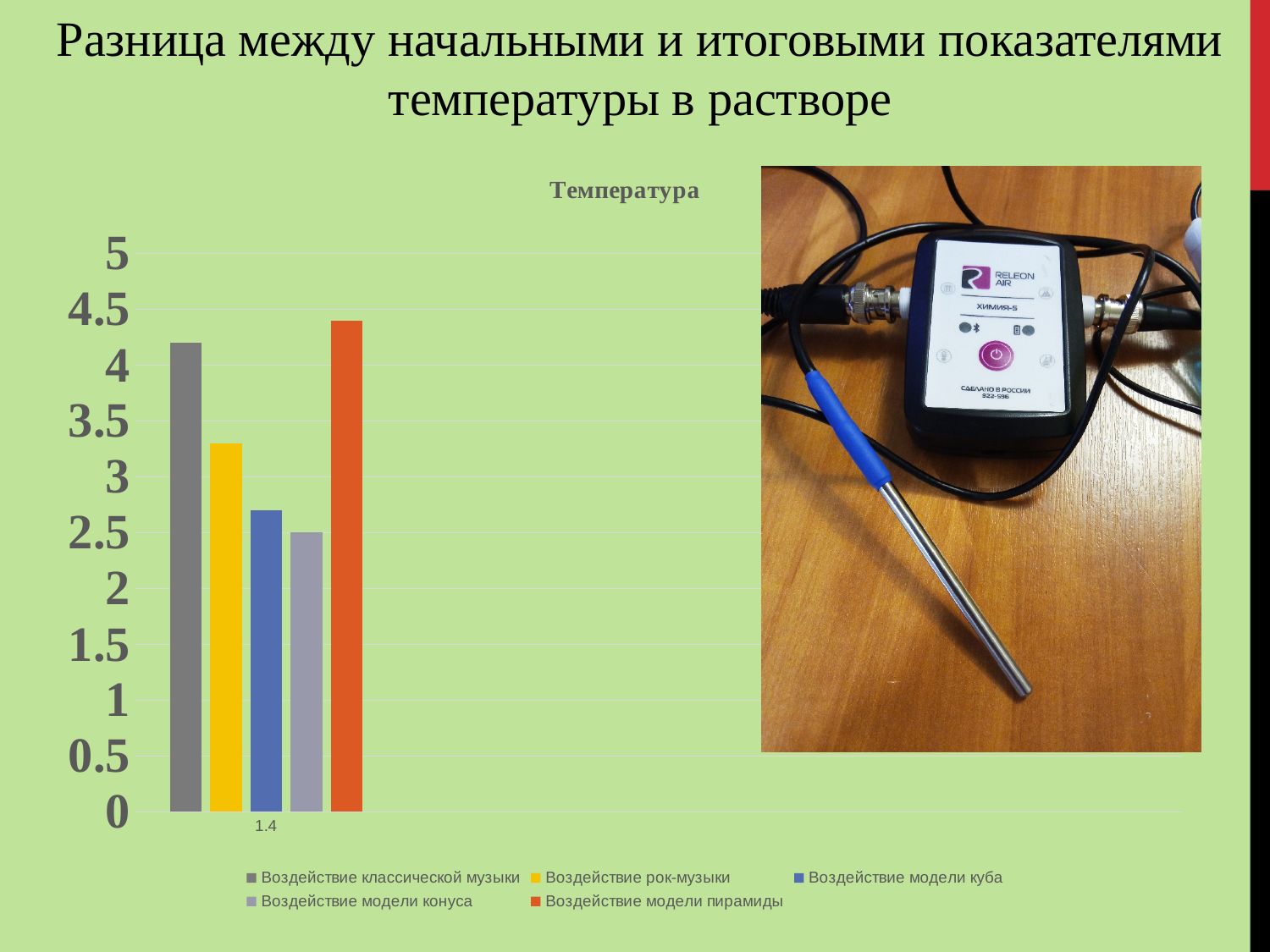
Is the value for Воздействие модели куба greater or less than 3? less Is the value for Воздействие классической музыки greater or less than 4? greater Is the value for Воздействие модели пирамиды greater or less than 4? greater Which is larger, the value for Воздействие модели куба or the value for Воздействие модели пирамиды? Воздействие модели пирамиды What colour is the bar for Воздействие рок-музыки? yellow What kind of chart is shown on the slide? bar chart Which series has the lowest bar in the chart? Воздействие модели конуса Which series has the highest bar in the chart? Воздействие модели пирамиды How many series does the chart legend list? 5 What is the title of the chart on the slide? Температура Which is larger, the value for Воздействие классической музыки or the value for Воздействие рок-музыки? Воздействие классической музыки